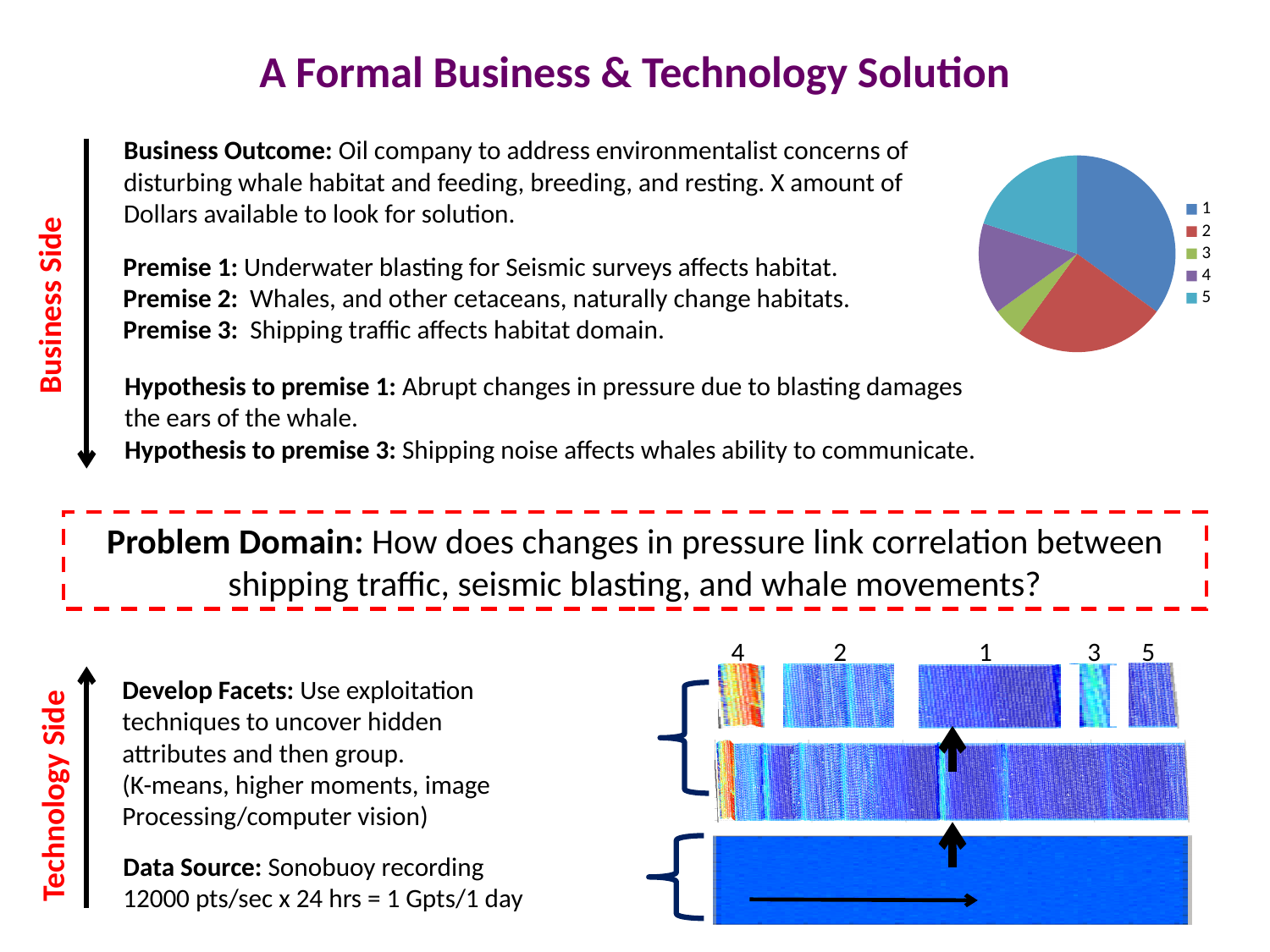
Which category has the largest slice in the pie chart? 1 What colour is the slice for category 1 in the pie chart? blue What colour is the slice for category 3 in the pie chart? green What kind of chart is shown in the top right of the slide? pie chart How many entries does the pie chart's legend list? 5 How many slices does the pie chart have? 5 In the pie chart, which slice is larger, category 1 or category 4? 1 In the pie chart, which slice is larger, category 4 or category 3? 4 In the pie chart, which slice is larger, category 1 or category 3? 1 Which category has the smallest slice in the pie chart? 3